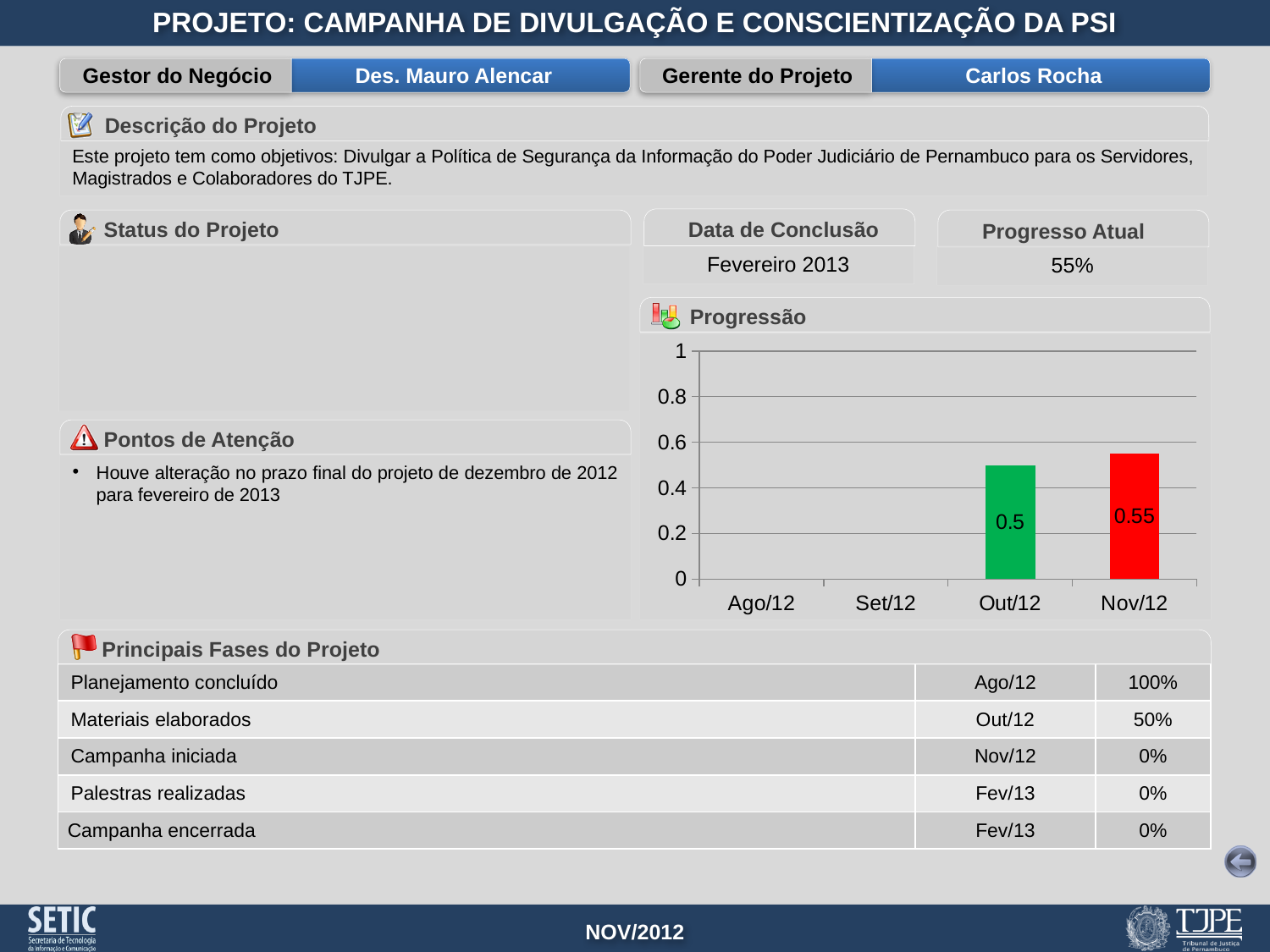
What type of chart is shown under "Progressão"? bar chart Is the value for Nov/12 in the Progressão chart greater or less than 0.6? less How many categories are shown on the x axis of the Progressão chart? 4 Is the value for Out/12 in the Progressão chart greater or less than 0.4? greater What colour is the Nov/12 bar in the Progressão chart? red What is the maximum value shown on the y axis of the Progressão chart? 1 Do the values in the Progressão chart rise or fall from Out/12 to Nov/12? rise What is the difference between the Nov/12 and Out/12 values in the Progressão chart? 0.05 In the Progressão chart, which is larger: the value for Out/12 or the value for Nov/12? Nov/12 Which category has the highest value in the Progressão chart? Nov/12 What is the value for Nov/12 in the Progressão chart? 0.55 What is the value for Out/12 in the Progressão chart? 0.5